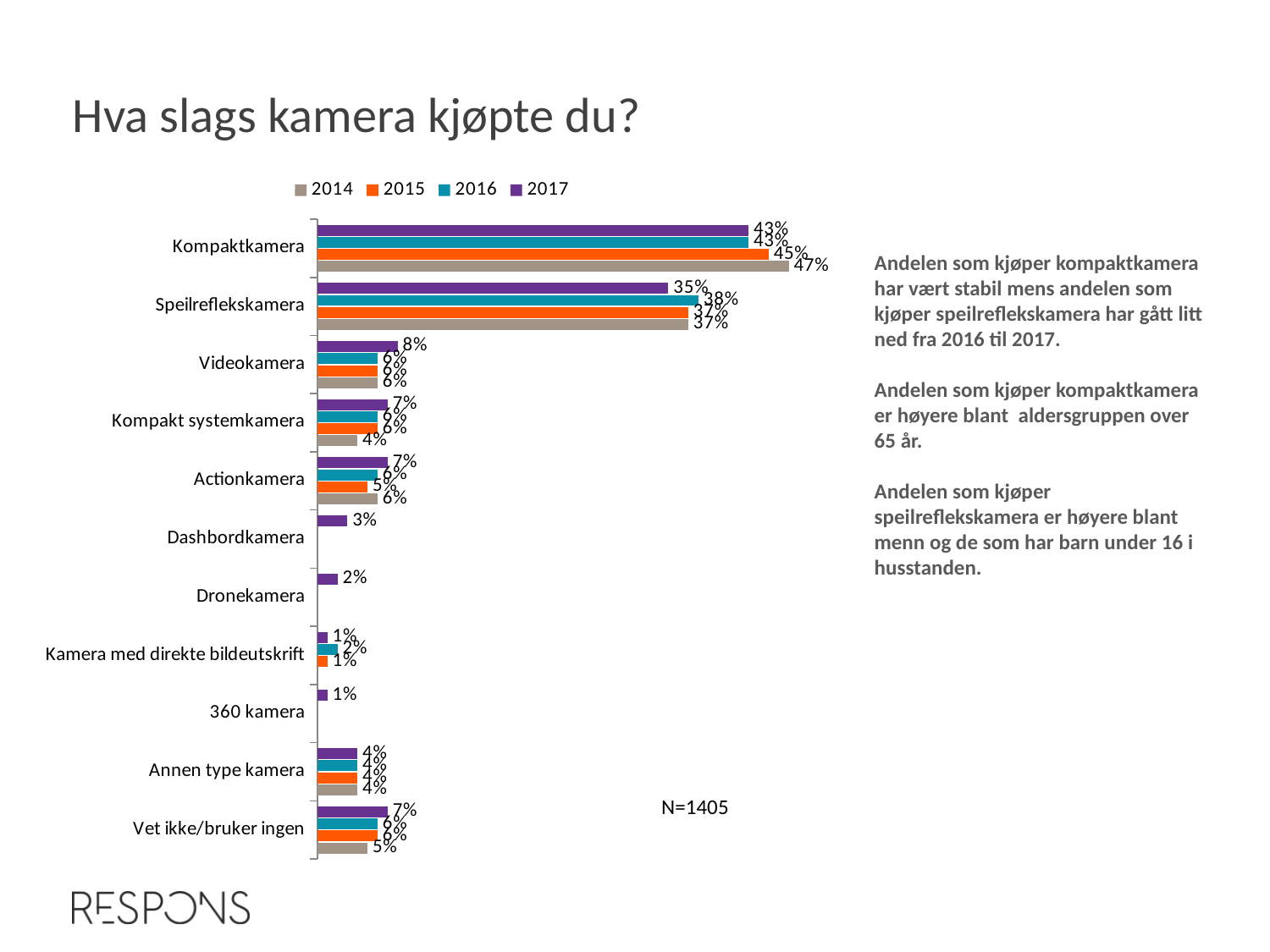
What sample size (N) is shown on the slide? N=1405 Which category has the highest value in 2017? Kompaktkamera How many series does the legend list? 4 What is the difference between the 2014 and 2017 values for Kompaktkamera? 4% What is the 2017 value for Dashbordkamera? 3% Which is larger for Speilreflekskamera: the 2014 value or the 2017 value? 2014 What type of chart is shown on the slide? bar chart What is the 2014 value for Kompakt systemkamera? 4% What is the 2017 value for Speilreflekskamera? 35% How many camera categories are shown on the chart? 11 What is the 2017 value for Videokamera? 8% What is the 2014 value for Kompaktkamera? 47%